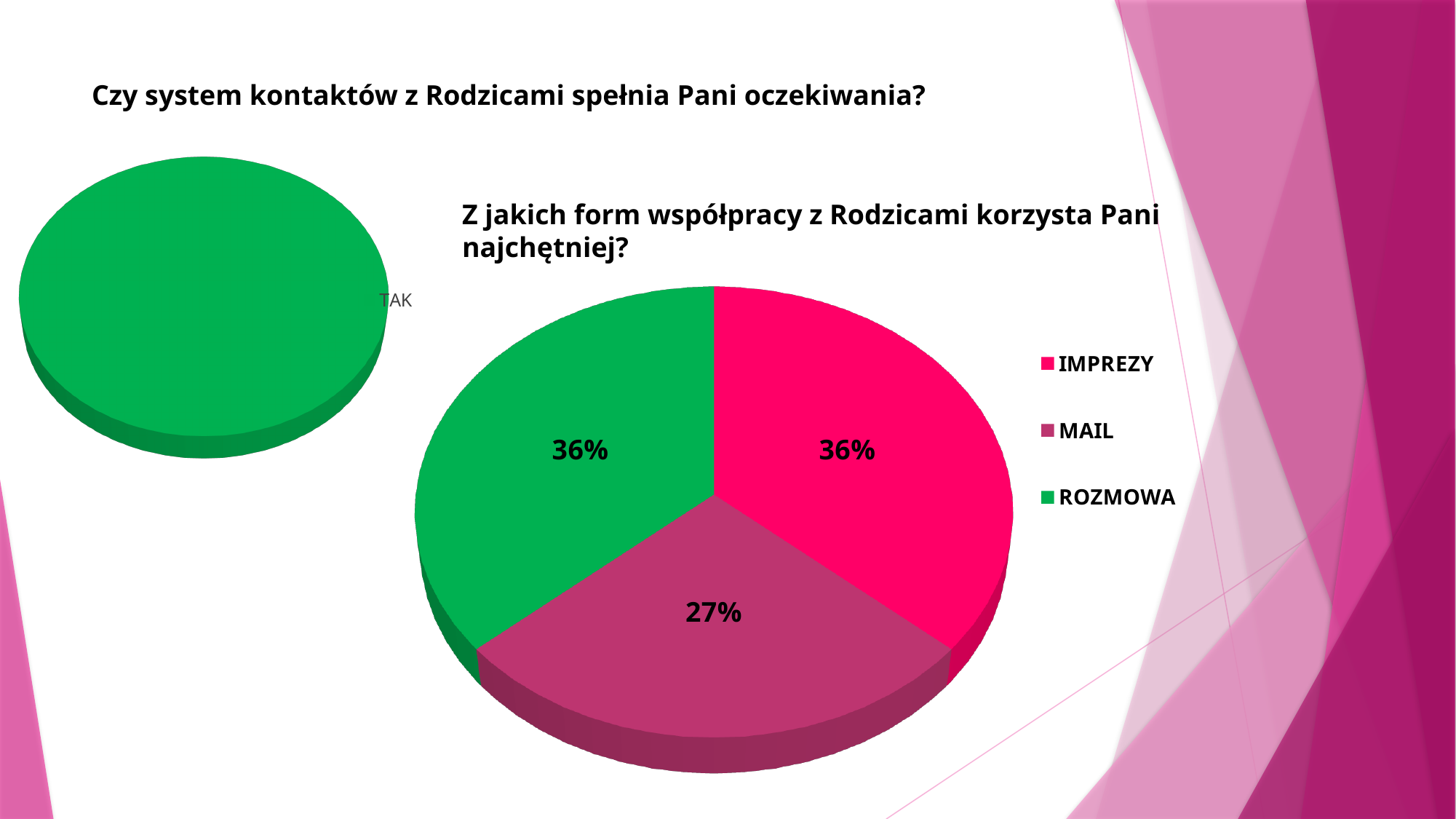
What kind of chart is the chart on the left of the slide, titled "Czy system kontaktów z Rodzicami spełnia Pani oczekiwania?"? Pie chart In the chart titled "Z jakich form współpracy z Rodzicami korzysta Pani najchętniej?", which colour represents ROZMOWA? Green In the chart titled "Z jakich form współpracy z Rodzicami korzysta Pani najchętniej?", which is larger, IMPREZY or MAIL? IMPREZY In the chart titled "Z jakich form współpracy z Rodzicami korzysta Pani najchętniej?", what share is shown for MAIL? 27% What kind of chart is the chart titled "Z jakich form współpracy z Rodzicami korzysta Pani najchętniej?"? Pie chart How many slices does the chart titled "Z jakich form współpracy z Rodzicami korzysta Pani najchętniej?" have? 3 In the chart titled "Z jakich form współpracy z Rodzicami korzysta Pani najchętniej?", what share is shown for ROZMOWA? 36% In the chart titled "Z jakich form współpracy z Rodzicami korzysta Pani najchętniej?", what is the difference in percentage points between ROZMOWA and MAIL? 9 percentage points How many entries does the legend of the chart titled "Z jakich form współpracy z Rodzicami korzysta Pani najchętniej?" list? 3 In the chart titled "Z jakich form współpracy z Rodzicami korzysta Pani najchętniej?", which category has the smallest share? MAIL In the chart titled "Z jakich form współpracy z Rodzicami korzysta Pani najchętniej?", what share is shown for IMPREZY? 36% How many slices does the chart on the left of the slide, titled "Czy system kontaktów z Rodzicami spełnia Pani oczekiwania?", have? 1